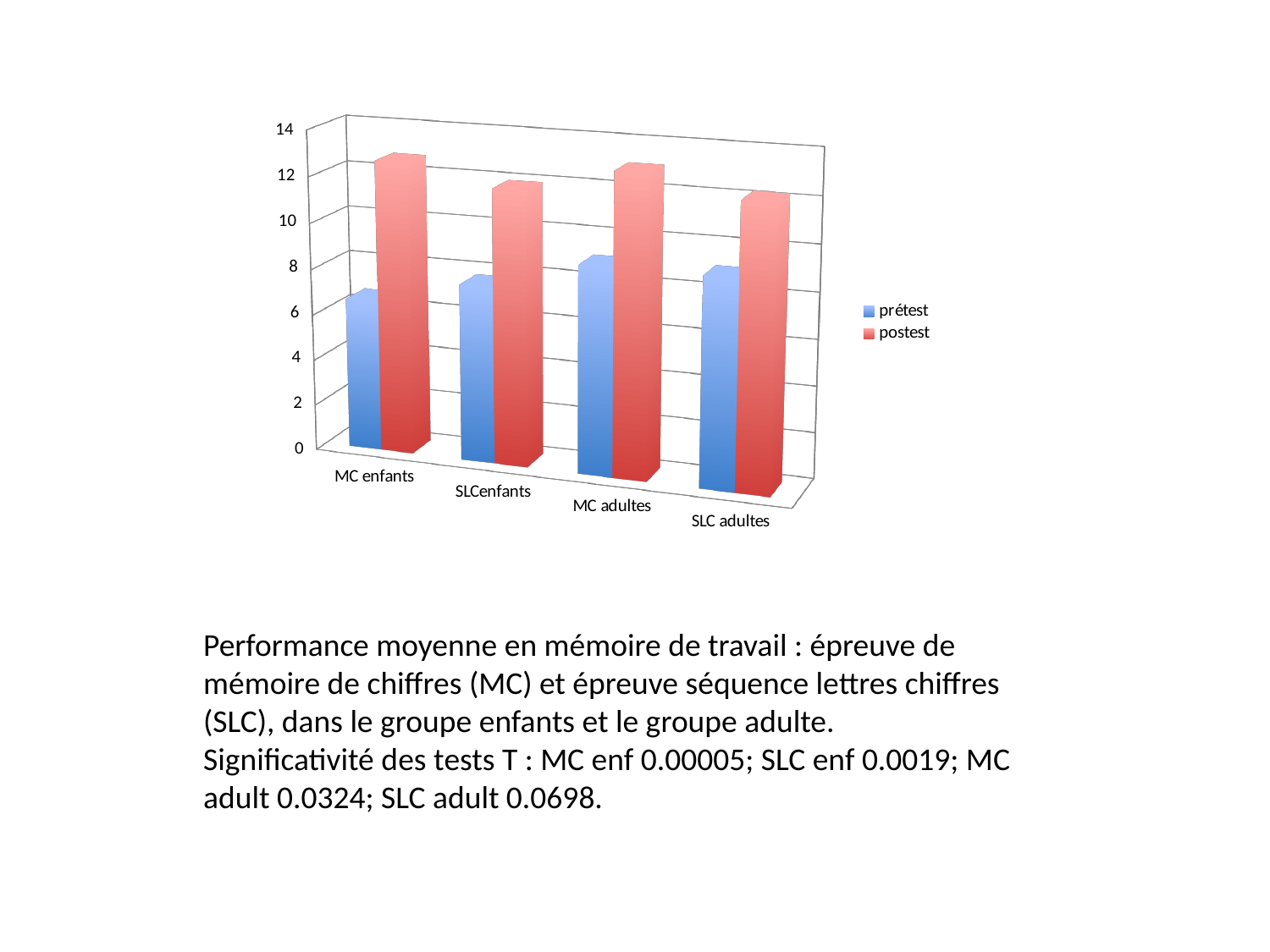
Is the postest value for MC enfants greater or less than 10? greater What kind of chart is shown on the slide? bar chart Is the postest value for SLC adultes greater or less than 8? greater For SLC adultes, which is larger: the prétest value or the postest value? postest How many categories are shown on the x axis of the chart? 4 Is the prétest value for MC enfants greater or less than 8? less Which colour represents the postest series in the chart? red What are the two series named in the chart's legend? prétest and postest For MC enfants, which is larger: the prétest value or the postest value? postest How many series does the chart's legend list? 2